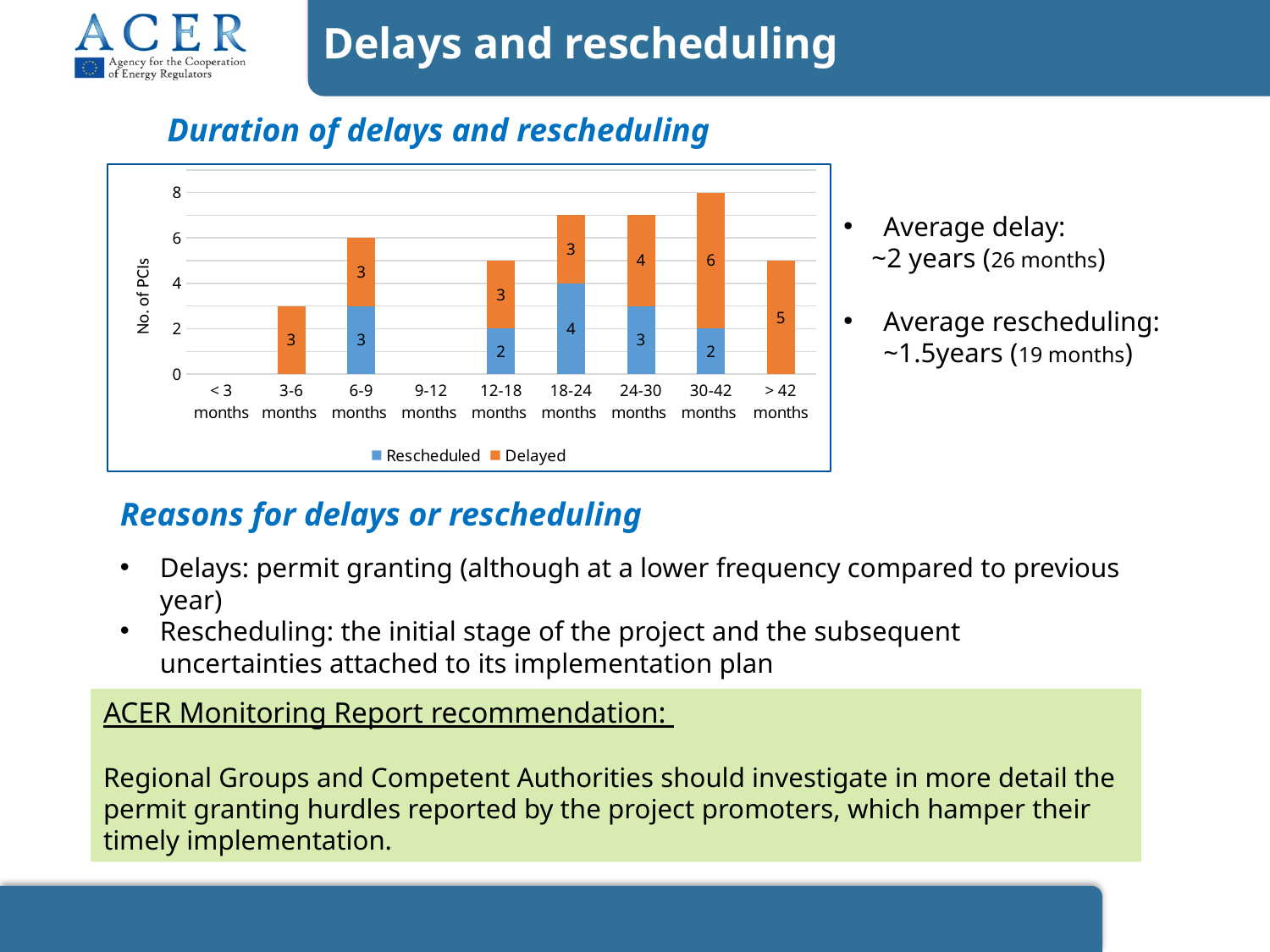
What is the Rescheduled value for the 18-24 months category? 4 What type of chart is shown under 'Duration of delays and rescheduling'? Stacked bar chart How many categories are shown on the x axis of the chart? 9 What is the difference between the Delayed value and the Rescheduled value in the 30-42 months category? 4 What is the total number of PCIs for the 24-30 months category? 7 What is the total number of PCIs for the 30-42 months category? 8 What is the Delayed value for the > 42 months category? 5 What is the Delayed value for the 30-42 months category? 6 How many series does the legend of the chart list? 2 Which is larger in the 24-30 months category, the Delayed value or the Rescheduled value? Delayed Which category has the highest Rescheduled value? 18-24 months Which category has the highest Delayed value? 30-42 months